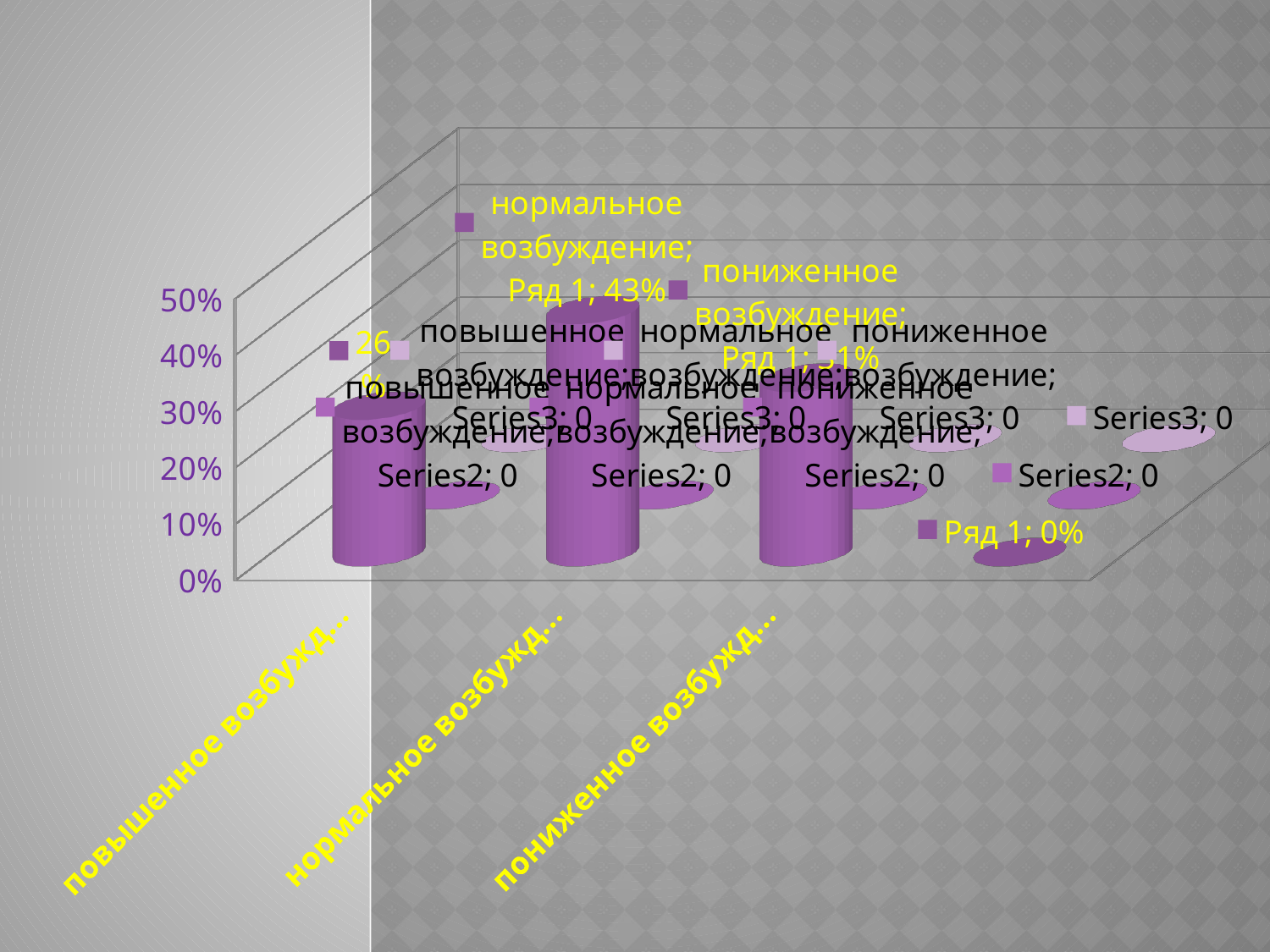
What is the highest value shown on the vertical axis? 50% Is the value for нормальное возбуждение greater or less than 40%? greater What is the value for повышенное возбуждение? 26% Is the value for повышенное возбуждение greater or less than 30%? less How many categories are labelled on the x axis? 3 Which labelled category has the highest value? нормальное возбуждение What is the value for нормальное возбуждение? 43% What kind of chart is shown on the slide? bar chart Which is larger, the value for пониженное возбуждение or the value for повышенное возбуждение? пониженное возбуждение What is the value for пониженное возбуждение? 31% Which is larger, the value for нормальное возбуждение or the value for повышенное возбуждение? нормальное возбуждение What is the difference between the values for нормальное возбуждение and повышенное возбуждение? 17 percentage points